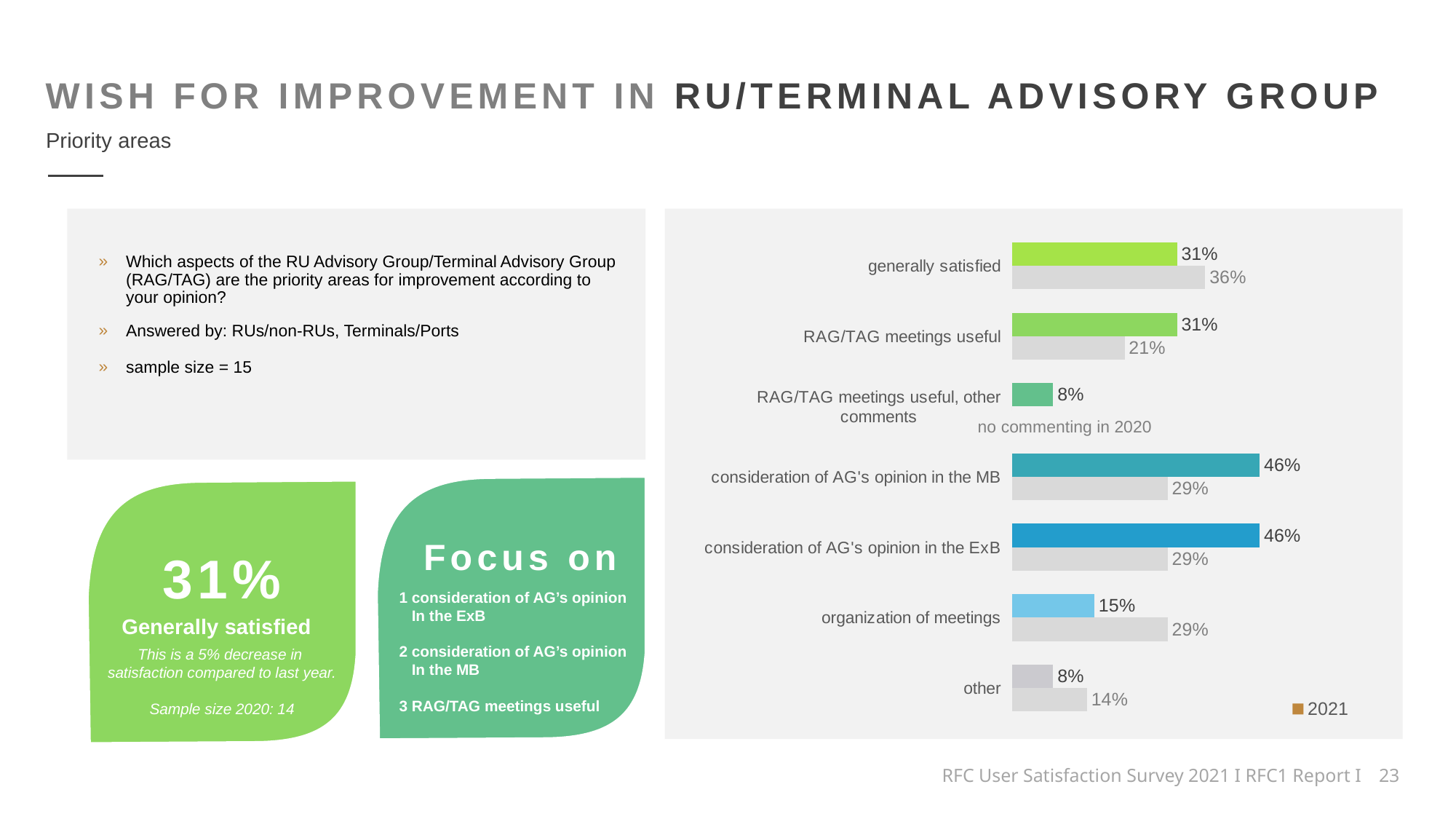
Which series is listed in the chart legend? 2021 What type of chart is shown on the slide? bar chart Which category has the highest 2020 value? generally satisfied What is the 2021 value for "organization of meetings"? 15% Which is larger for "organization of meetings": the 2021 value or the 2020 value? 2020 What is the difference between the 2021 and 2020 values for "consideration of AG's opinion in the ExB"? 17% What is the 2021 value for "consideration of AG's opinion in the MB"? 46% What is the 2020 value for "generally satisfied"? 36% What does the chart say about the 2020 value for "RAG/TAG meetings useful, other comments"? no commenting in 2020 How many categories are shown on the chart? 7 What is the 2020 value for "RAG/TAG meetings useful"? 21%